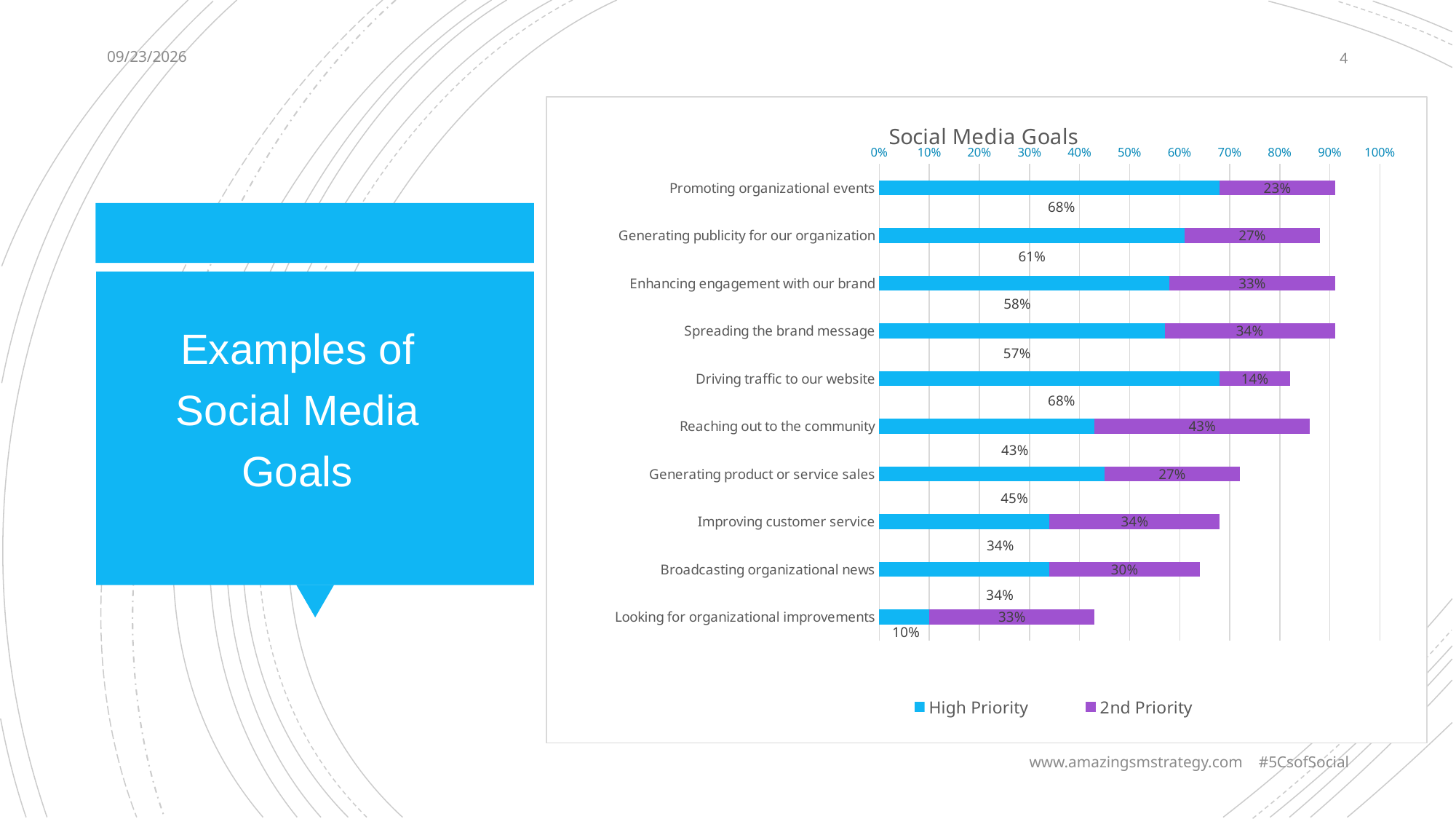
What is the 2nd Priority value for Driving traffic to our website? 14% Which category has the lowest 2nd Priority value? Driving traffic to our website What is the total of the stacked bar for Improving customer service? 68% What is the High Priority value for Generating publicity for our organization? 61% Which category has the highest 2nd Priority value? Reaching out to the community What is the difference between the High Priority values for Promoting organizational events and Spreading the brand message? 11% What type of chart is shown on the slide? Stacked bar chart Which category has the lowest High Priority value? Looking for organizational improvements How many series does the legend list? 2 What is the High Priority value for Looking for organizational improvements? 10% Which is larger: the High Priority value for Reaching out to the community or for Generating product or service sales? Generating product or service sales How many categories are shown in the chart? 10